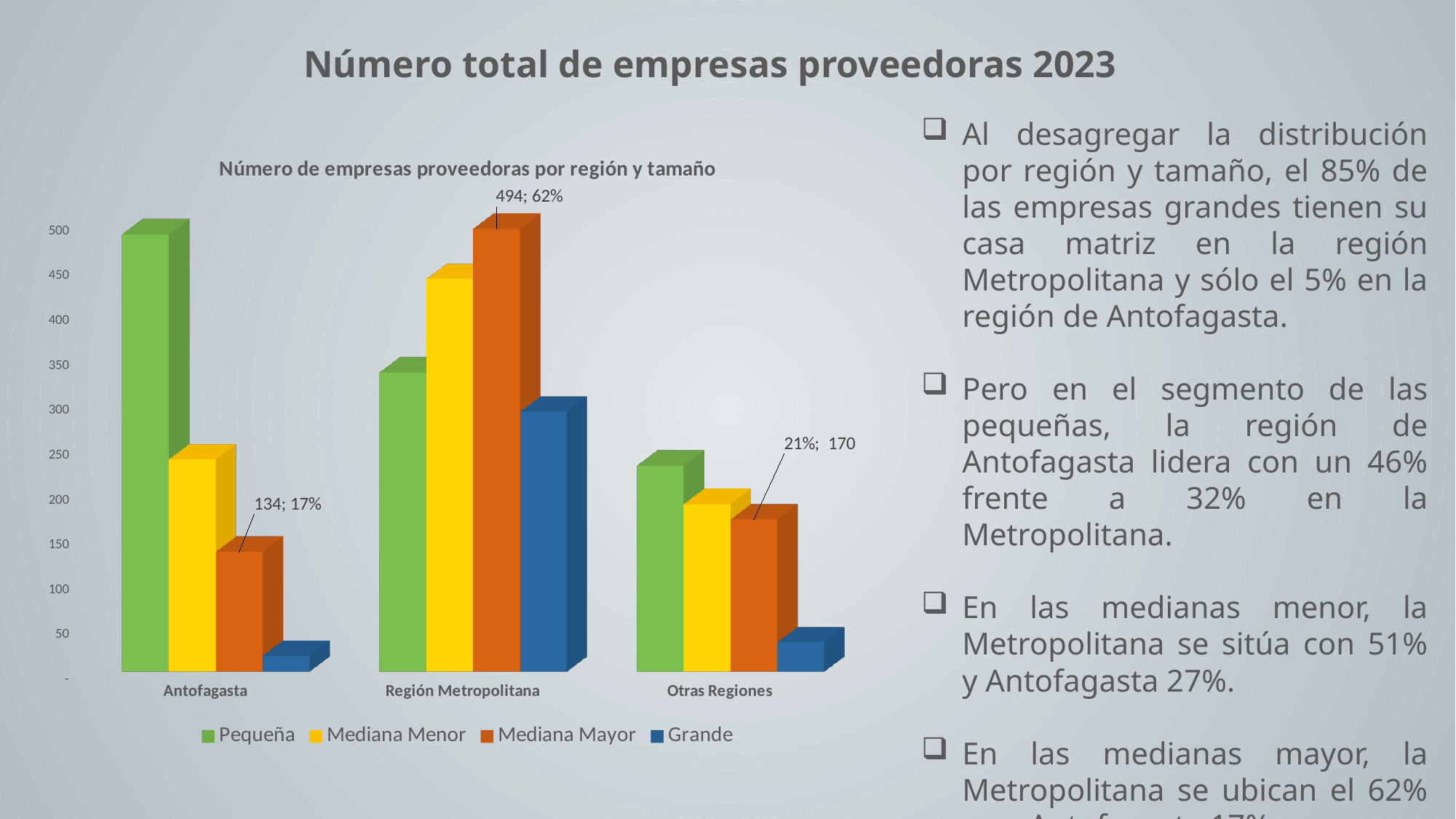
How many series does the legend list? 4 What type of chart is shown on the slide? Bar chart Is the value of the Grande bar for Región Metropolitana greater or less than 250? greater Which is larger: the Pequeña bar for Antofagasta or the Pequeña bar for Región Metropolitana? Antofagasta What is the difference between the Mediana Mayor values for Región Metropolitana and Antofagasta? 360 How many regions (categories) are shown on the x axis? 3 Is the value of the Grande bar for Antofagasta greater or less than 50? less What is the value of the Mediana Mayor bar for Antofagasta? 134 Which region has the highest Mediana Mayor value? Región Metropolitana What is the value of the Mediana Mayor bar for Otras Regiones? 170 What is the value of the Mediana Mayor bar for Región Metropolitana? 494 What percentage is shown in the data label for Mediana Mayor in Región Metropolitana? 62%